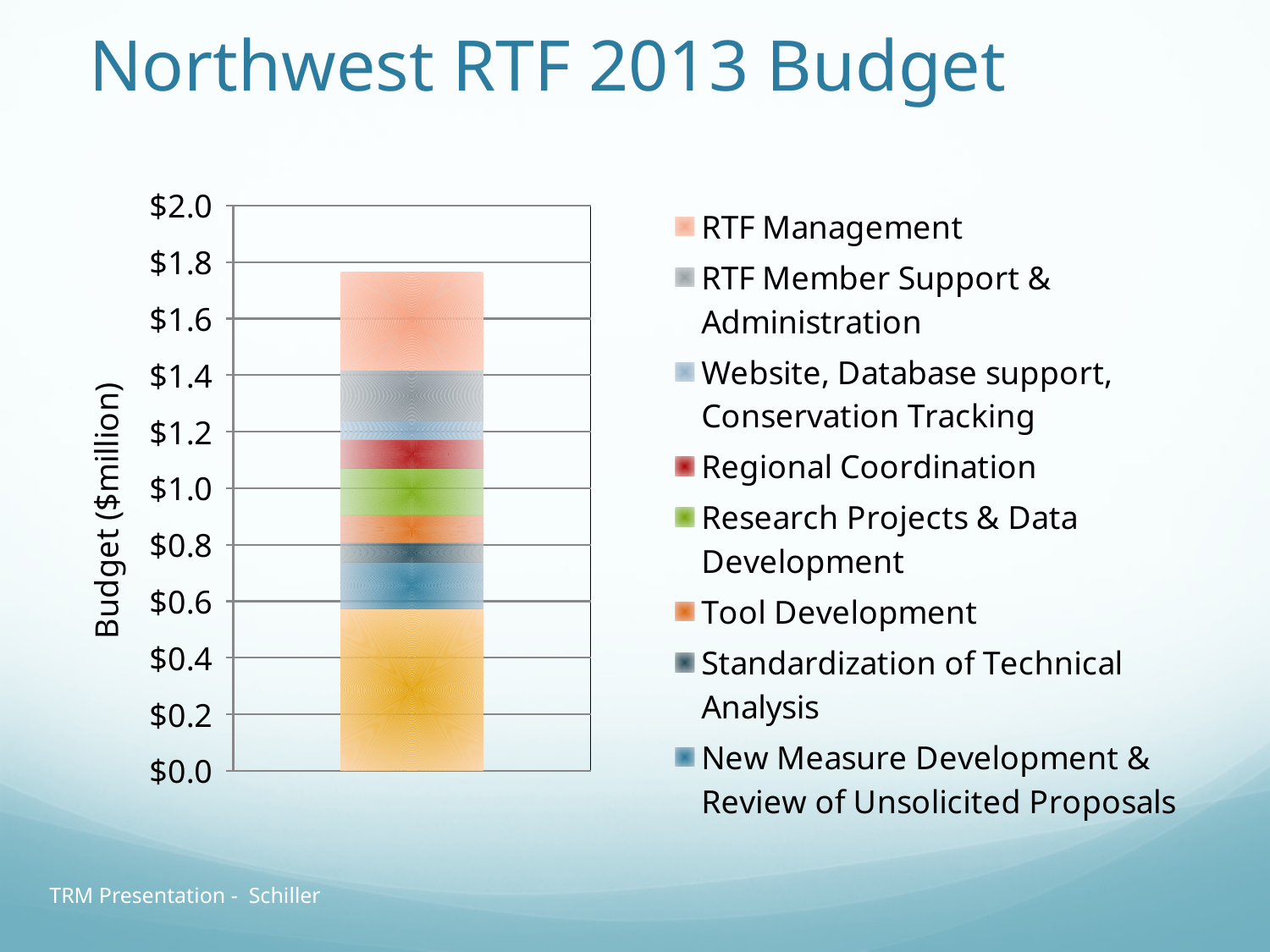
What is the title of the slide containing the chart? Northwest RTF 2013 Budget What is the label of the vertical axis? Budget ($million) How many bars are plotted in the chart? 1 How many categories does the legend list? 8 Which segment is larger: Research Projects & Data Development or Regional Coordination? Research Projects & Data Development What kind of chart is shown on the slide? Stacked bar chart Is the total height of the stacked bar greater or less than $1.6? greater Is the total height of the stacked bar greater or less than $2.0? less Which segment is larger: RTF Management or Regional Coordination? RTF Management What is the highest value shown on the vertical axis? $2.0 Among the categories listed in the legend, which one has the largest segment in the stacked bar? RTF Management